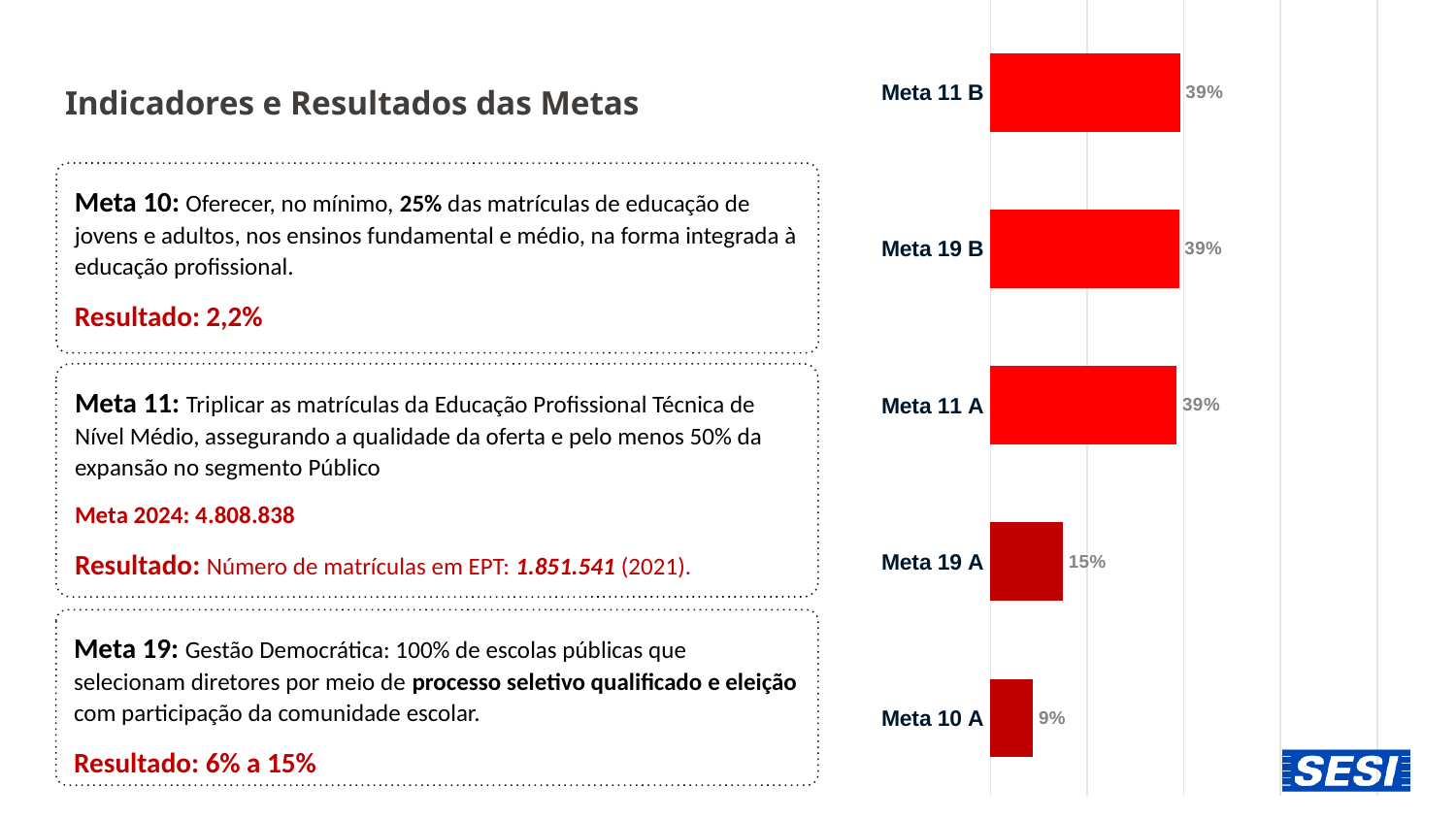
What is the value for Meta 10 A? 9% Which category has the lowest value? Meta 10 A What is the value for Meta 11 A? 39% What is the value for Meta 11 B? 39% What kind of chart is shown on the slide? Bar chart How many categories are shown in the chart? 5 What is the value for Meta 19 A? 15% Which is larger, the value for Meta 19 A or the value for Meta 10 A? Meta 19 A Which is larger, the value for Meta 11 A or the value for Meta 19 A? Meta 11 A What is the difference between the values for Meta 19 A and Meta 10 A? 6% What is the difference between the values for Meta 19 B and Meta 19 A? 24% How many bars in the chart have a value of 39%? 3